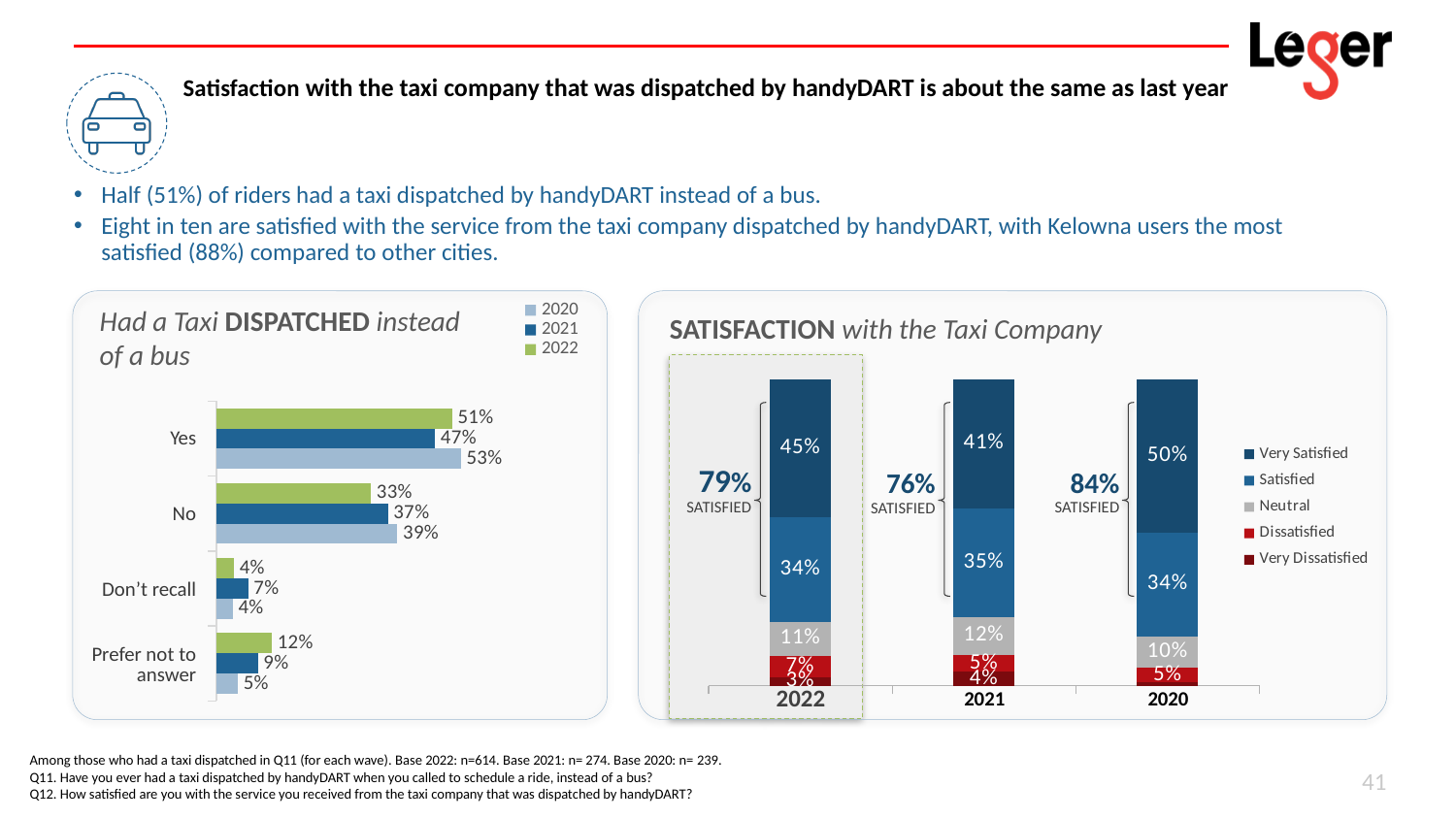
In the 'Had a Taxi DISPATCHED instead of a bus' chart, how many series does the legend list? 3 In the 'Had a Taxi DISPATCHED instead of a bus' chart, what is the difference between the 2022 and 2021 values for 'Prefer not to answer'? 3% In the 'Had a Taxi DISPATCHED instead of a bus' chart, how many response categories are shown? 4 In the 'SATISFACTION with the Taxi Company' chart, how many series does the legend list? 5 In the 'Had a Taxi DISPATCHED instead of a bus' chart, which year had the highest Yes value? 2020 In the 'SATISFACTION with the Taxi Company' chart, which year had the highest overall satisfied percentage? 2020 In the 'SATISFACTION with the Taxi Company' chart, what percentage were Very Satisfied in 2020? 50% In the 'Had a Taxi DISPATCHED instead of a bus' chart, what percentage answered Yes in 2022? 51% In the 'Had a Taxi DISPATCHED instead of a bus' chart, what percentage answered No in 2020? 39% What type of chart is the 'SATISFACTION with the Taxi Company' chart? Stacked bar chart In the 'SATISFACTION with the Taxi Company' chart, is the Very Satisfied value larger in 2022 or 2021? 2022 In the 'SATISFACTION with the Taxi Company' chart, what is the Neutral value for 2021? 12%